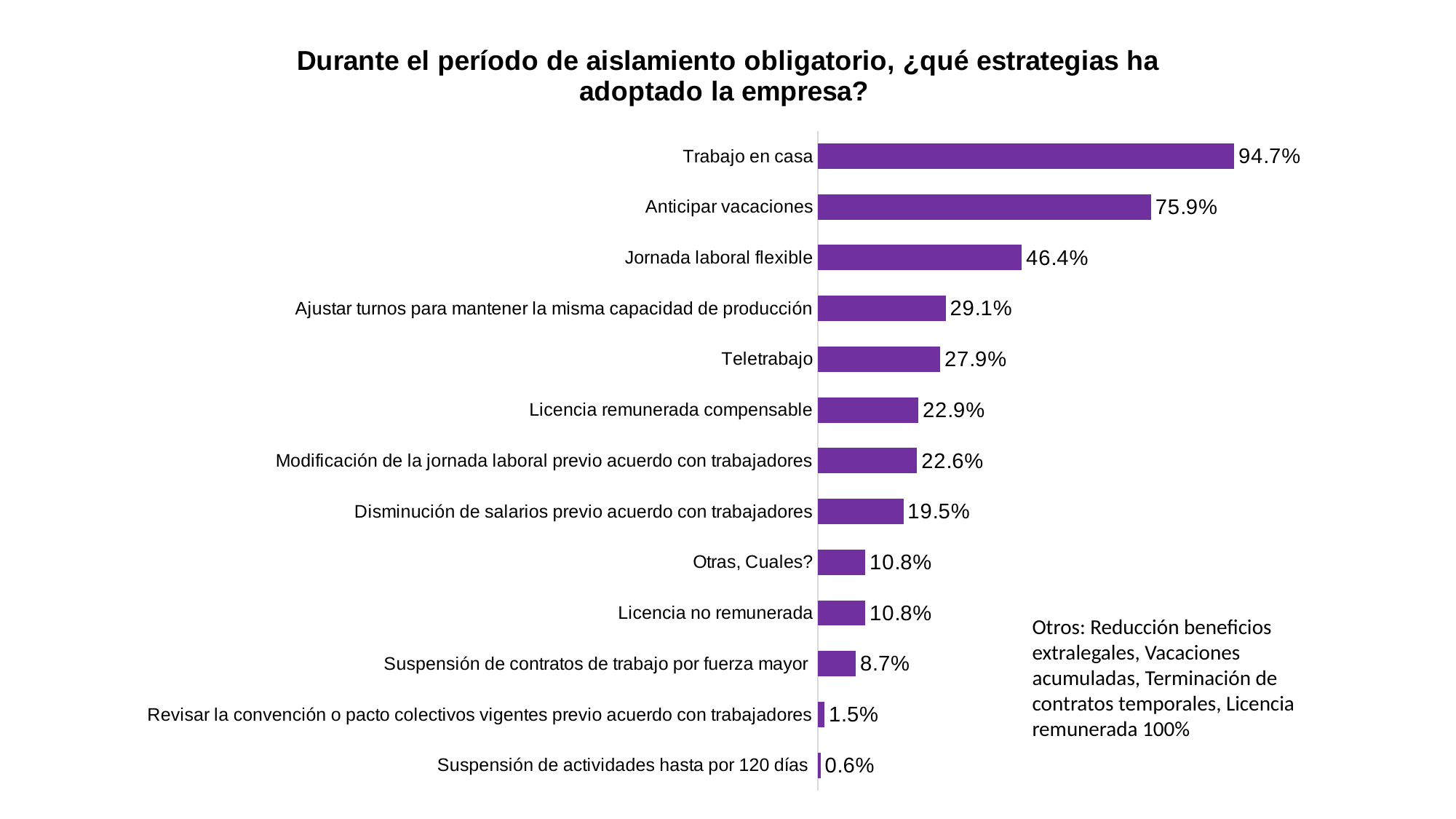
What kind of chart is shown on the slide? Bar chart What is the value for Suspensión de contratos de trabajo por fuerza mayor? 8.7% What is the title of the chart? Durante el período de aislamiento obligatorio, ¿qué estrategias ha adoptado la empresa? Which is larger, the value for Anticipar vacaciones or the value for Jornada laboral flexible? Anticipar vacaciones What is the value for Jornada laboral flexible? 46.4% What is the value for Teletrabajo? 27.9% Which category has the lowest value? Suspensión de actividades hasta por 120 días What is the value for Trabajo en casa? 94.7% How many categories are shown in the chart? 13 What is the difference between the values for Trabajo en casa and Anticipar vacaciones? 18.8% What is the difference between the values for Jornada laboral flexible and Teletrabajo? 18.5% Which category has the highest value? Trabajo en casa